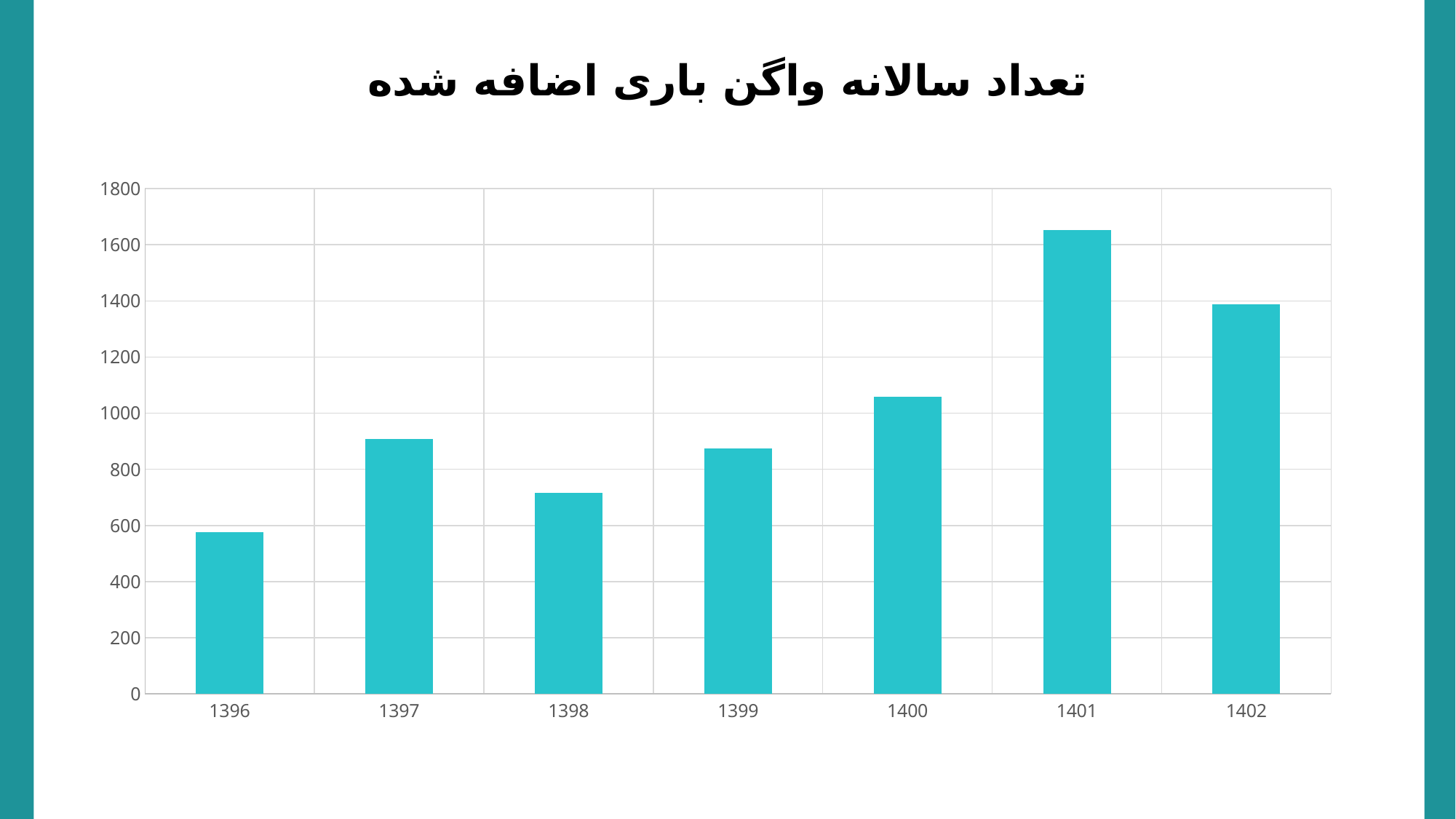
Is the value for 1402 greater or less than 1200? greater Is the value for 1400 greater or less than 1000? greater Is the value for 1396 greater or less than 800? less What kind of chart is shown on the slide? bar chart How many years (categories) are shown on the x axis? 7 Which year has the highest bar? 1401 Which is larger, the value for 1397 or the value for 1398? 1397 Which is larger, the value for 1402 or the value for 1400? 1402 What is the title of the chart? تعداد سالانه واگن باری اضافه شده Which year has the lowest bar? 1396